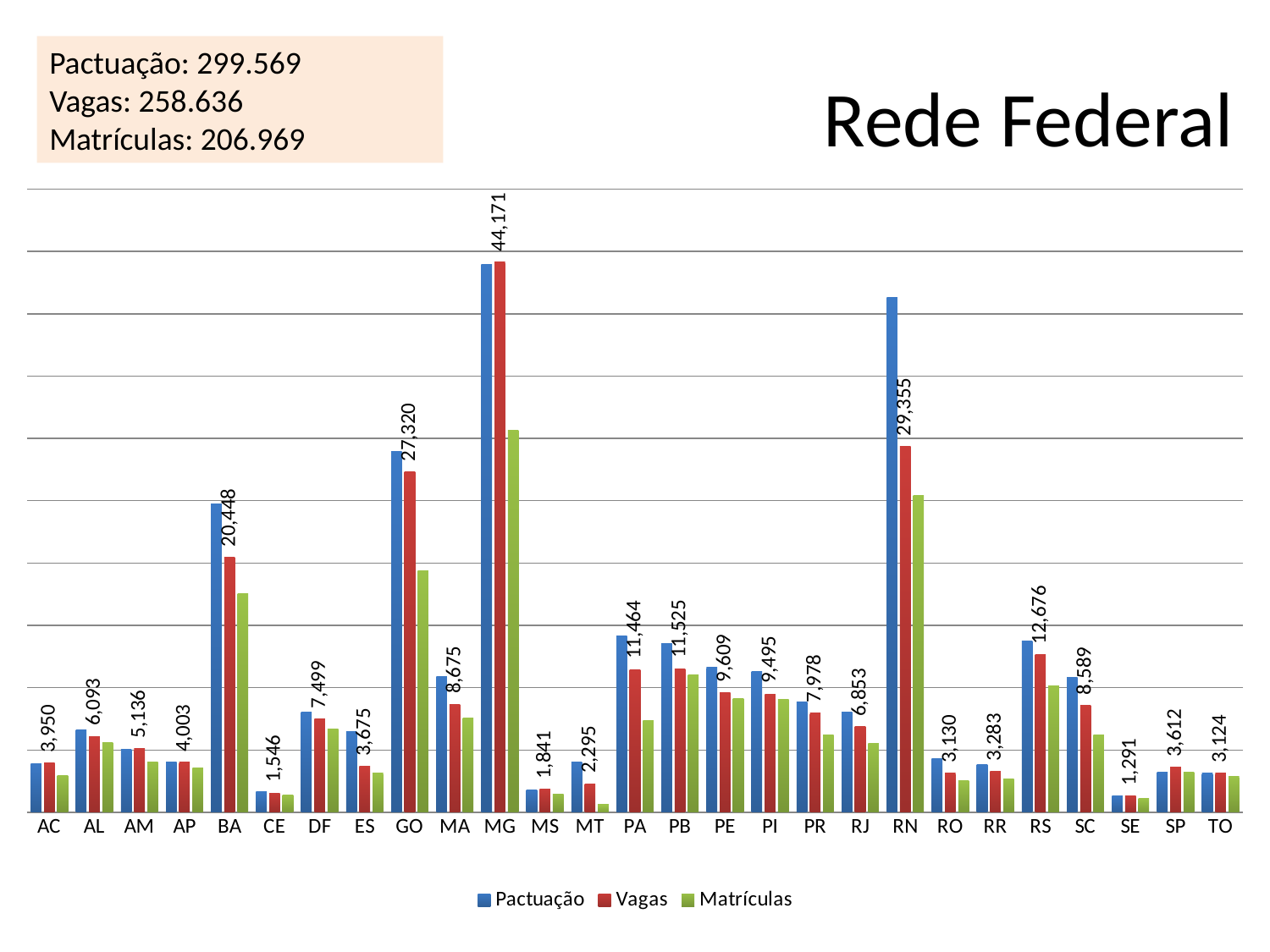
How many states are shown on the x axis of the chart? 27 What value is printed as the data label for RS? 12,676 Which state has the lowest labelled value on the chart? SE What type of chart is shown on the slide? Bar chart Which has the larger labelled value, PE or PI? PE What value is printed as the data label for SE? 1,291 How many series does the legend list? 3 What value is printed as the data label for RN? 29,355 What value is printed as the data label for MG? 44,171 Which state has the highest labelled value on the chart? MG What value is printed as the data label for BA? 20,448 What is the difference between the labelled values for GO and BA? 6,872